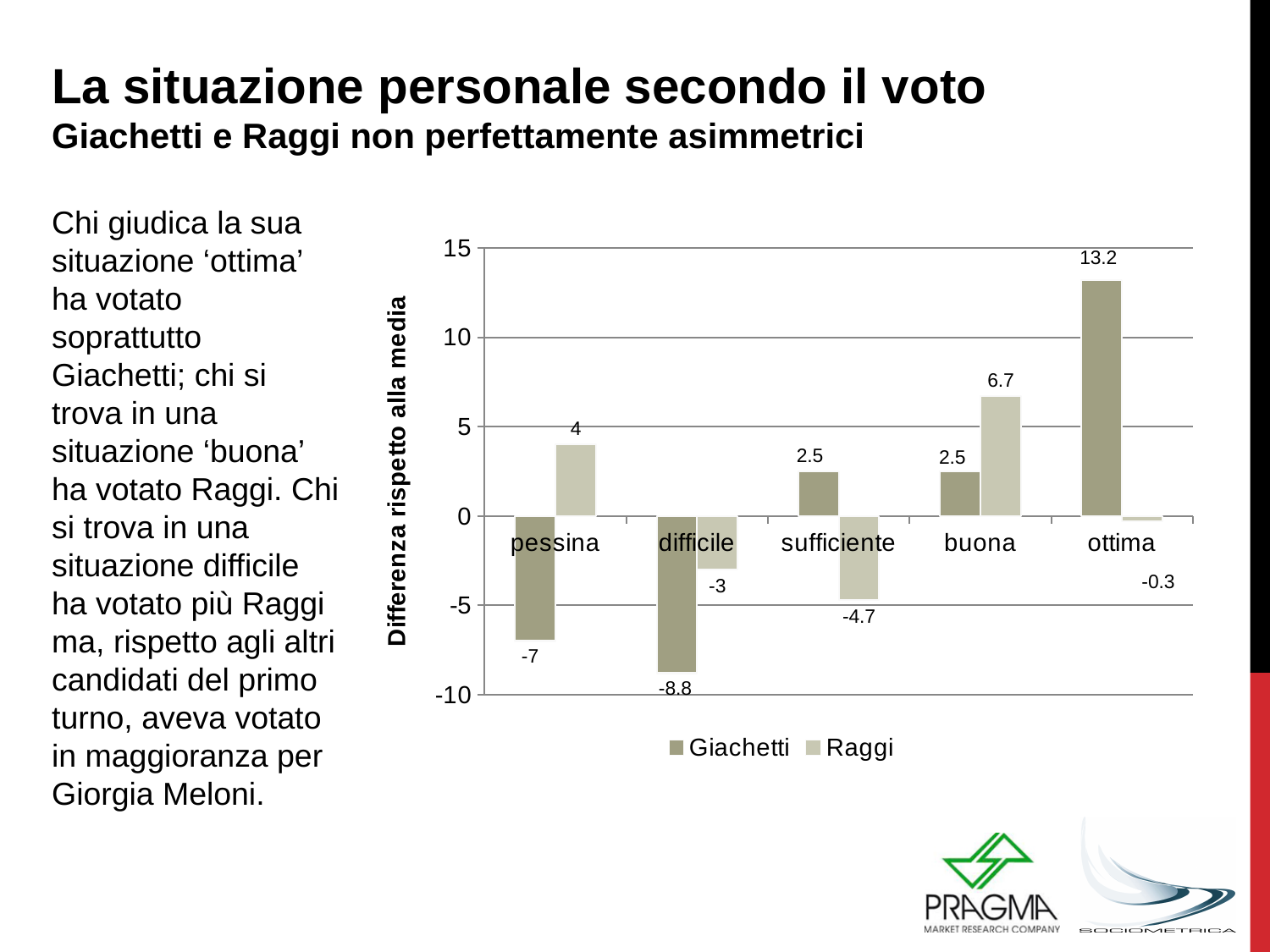
What is the value for Raggi in the 'sufficiente' category? -4.7 In which category is the Giachetti value highest? ottima What is the difference between the Raggi value and the Giachetti value in the 'buona' category? 4.2 How many series does the legend list? 2 What is the value for Giachetti in the 'difficile' category? -8.8 What is the label of the vertical axis? Differenza rispetto alla media In which category is the Raggi value lowest? sufficiente What is the value for Raggi in the 'pessina' category? 4 What kind of chart is shown on the slide? Bar chart What is the value for Giachetti in the 'ottima' category? 13.2 In the 'pessina' category, which series has the larger value, Giachetti or Raggi? Raggi How many categories are shown on the x axis? 5